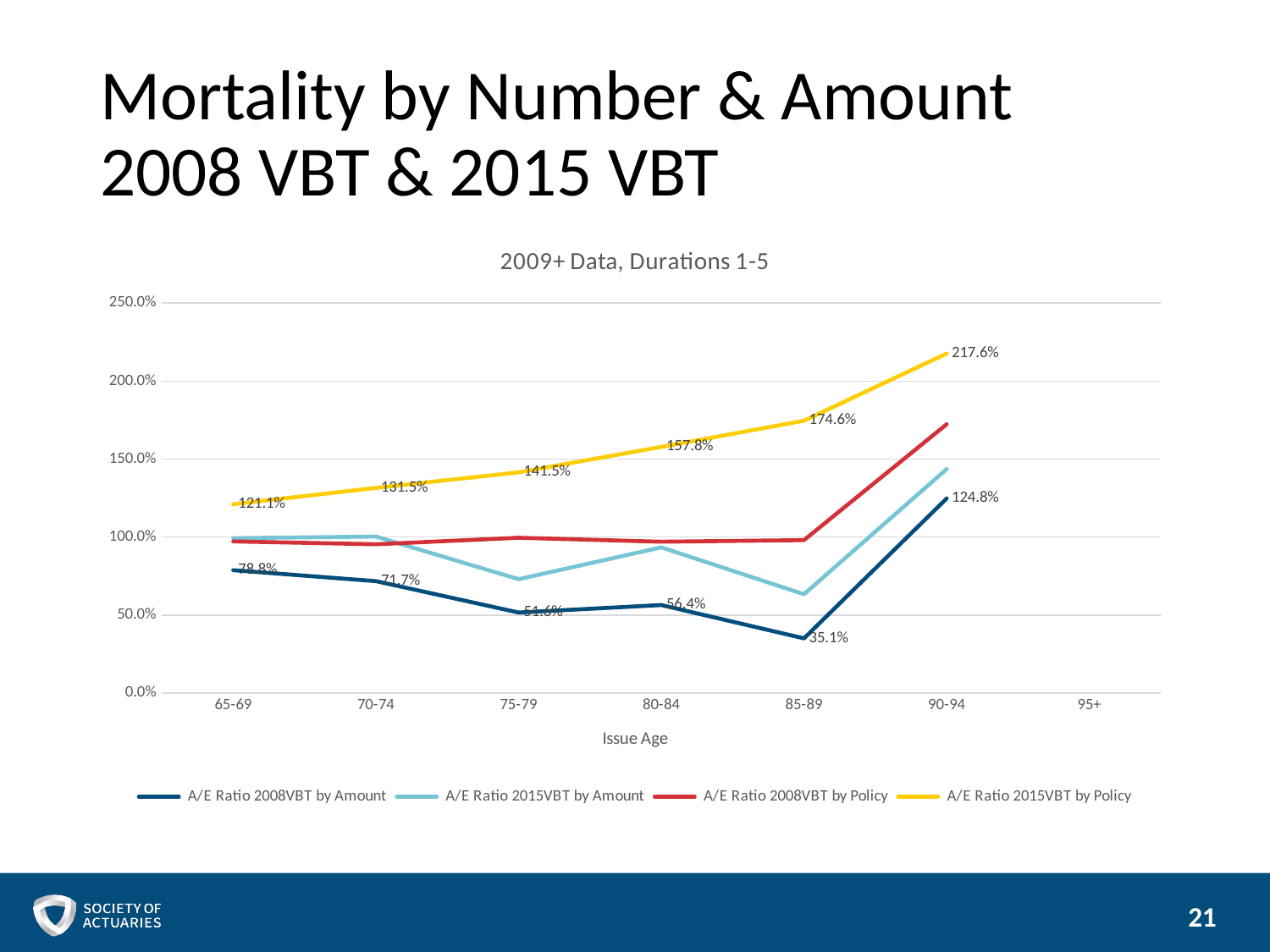
Does the A/E Ratio 2015VBT by Policy rise or fall from issue age 65-69 to 90-94? rise What is the A/E Ratio 2015VBT by Policy for issue age 90-94? 217.6% What is the A/E Ratio 2008VBT by Amount for issue age 90-94? 124.8% At issue age 80-84, which is larger: the A/E Ratio 2015VBT by Policy or the A/E Ratio 2008VBT by Amount? A/E Ratio 2015VBT by Policy Is the A/E Ratio 2008VBT by Policy at issue age 90-94 greater or less than 150.0%? greater How many issue age categories are shown on the x axis? 7 How many series does the legend list? 4 At which issue age is the A/E Ratio 2008VBT by Amount lowest? 85-89 What is the A/E Ratio 2015VBT by Policy for issue age 65-69? 121.1% At which issue age is the A/E Ratio 2015VBT by Policy highest? 90-94 What is the A/E Ratio 2008VBT by Amount for issue age 85-89? 35.1% How much higher is the A/E Ratio 2015VBT by Policy at issue age 90-94 than at issue age 85-89? 43.0%